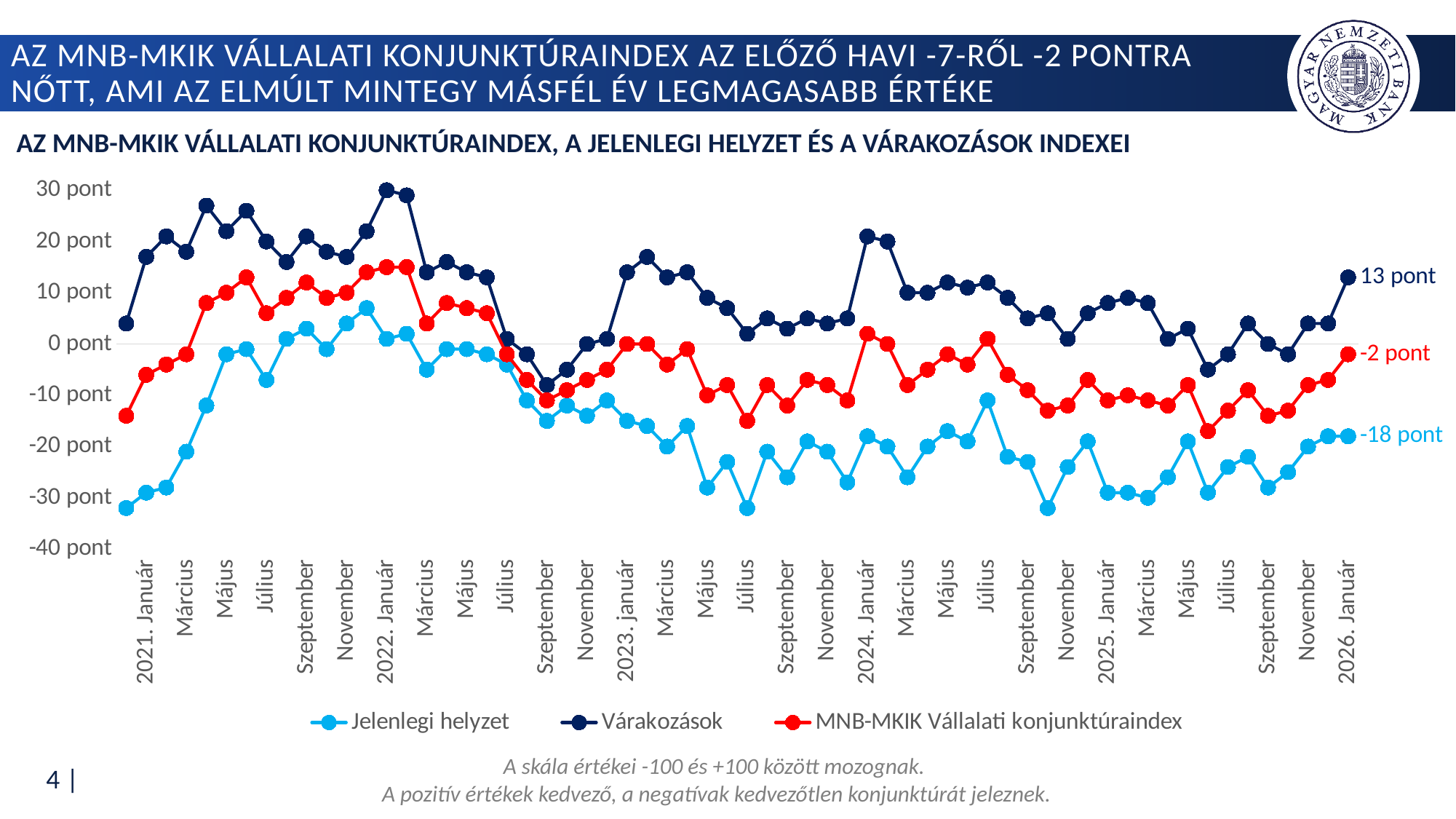
At 2026. Január, which is larger: the Várakozások value or the Jelenlegi helyzet value? Várakozások Which series has the highest value at 2026. Január? Várakozások What is the value of the Jelenlegi helyzet series at 2026. Január? -18 pont What kind of chart is shown on the slide? Line chart Is the value of the Várakozások series at 2022. Január greater or less than 20 pont? greater How many series does the legend list? 3 What is the value of the Várakozások series at 2026. Január? 13 pont What is the difference between the Várakozások and the MNB-MKIK Vállalati konjunktúraindex values at 2026. Január? 15 pont What is the difference between the MNB-MKIK Vállalati konjunktúraindex and the Jelenlegi helyzet values at 2026. Január? 16 pont Which series has the lowest value at 2026. Január? Jelenlegi helyzet What is the value of the MNB-MKIK Vállalati konjunktúraindex series at 2026. Január? -2 pont